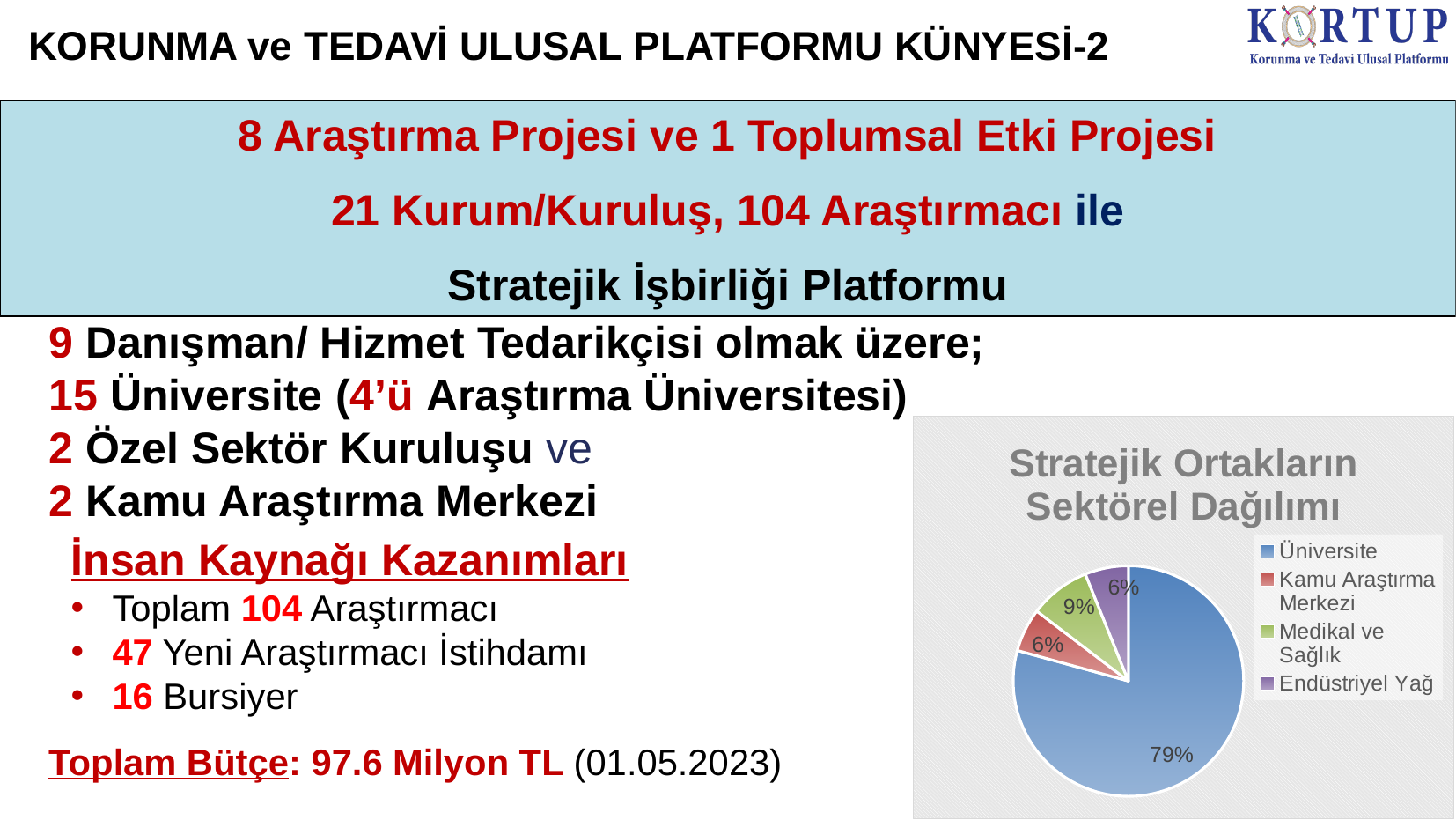
What share of the pie does Üniversite hold? 79% Is the share for Üniversite greater or less than 50%? greater How many categories does the legend list? 4 What type of chart is shown on the slide? pie chart What is the title of the pie chart? Stratejik Ortakların Sektörel Dağılımı Which colour represents Üniversite in the pie chart? blue What percentage is shown for Medikal ve Sağlık? 9% What is the difference in percentage points between Üniversite and Medikal ve Sağlık? 70 Which is larger, the share for Medikal ve Sağlık or the share for Endüstriyel Yağ? Medikal ve Sağlık What percentage is shown for Endüstriyel Yağ? 6% Which category has the largest slice of the pie? Üniversite What percentage is shown for Kamu Araştırma Merkezi? 6%